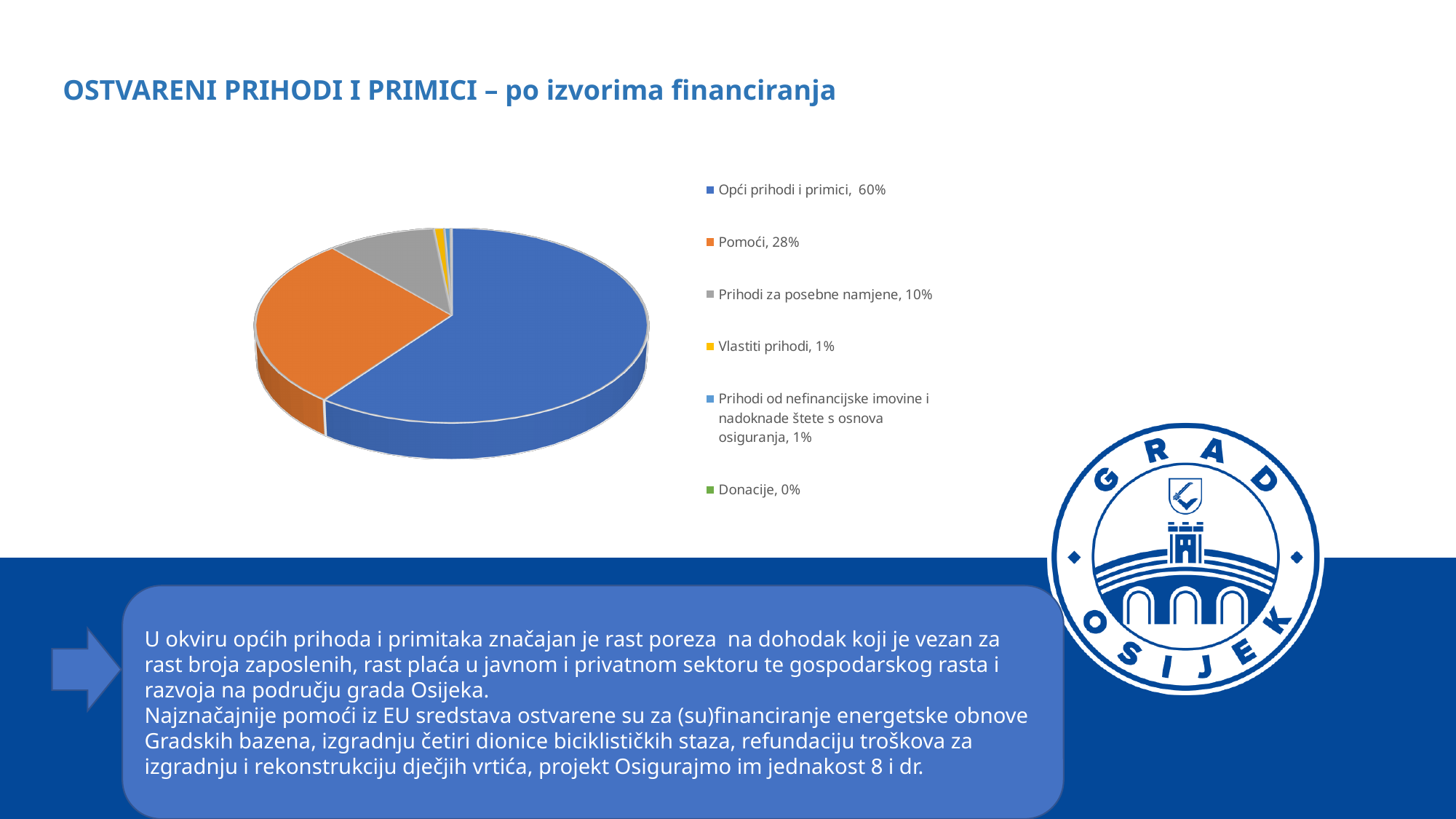
Which is larger, the share for "Pomoći" or the share for "Prihodi za posebne namjene"? Pomoći What is the difference in percentage points between "Opći prihodi i primici" and "Pomoći"? 32 percentage points What kind of chart is shown on the slide? Pie chart What is the value shown for "Pomoći"? 28% Which category has the smallest share of the pie? Donacije Which category has the largest share of the pie? Opći prihodi i primici What share of the pie does "Opći prihodi i primici" represent? 60% What is the value shown for "Vlastiti prihodi"? 1% What is the value shown for "Prihodi za posebne namjene"? 10% What colour is the slice for "Pomoći"? Orange How many categories does the legend of the pie chart list? 6 What is the value shown for "Donacije"? 0%